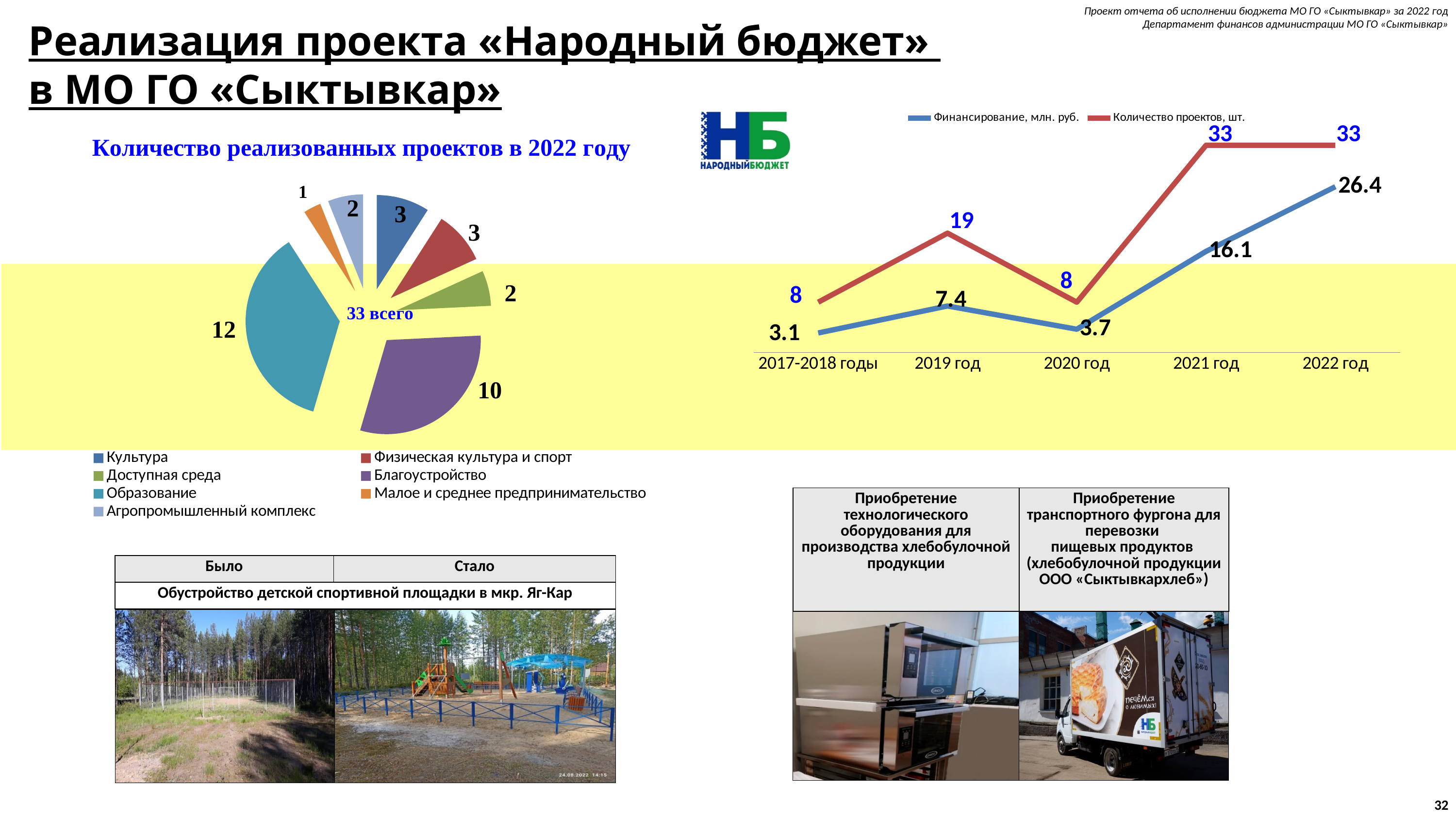
In the pie chart 'Количество реализованных проектов в 2022 году', what is the difference between 'Образование' and 'Благоустройство'? 2 In the line chart on the right, what is the difference in 'Финансирование, млн. руб.' between 2022 год and 2021 год? 10.3 In the pie chart 'Количество реализованных проектов в 2022 году', how many projects are in the 'Образование' category? 12 In the pie chart 'Количество реализованных проектов в 2022 году', what is the total number of projects shown in the centre? 33 всего In the pie chart 'Количество реализованных проектов в 2022 году', which category has the smallest number of projects? Малое и среднее предпринимательство In the pie chart 'Количество реализованных проектов в 2022 году', how many projects are in the 'Благоустройство' category? 10 In the pie chart 'Количество реализованных проектов в 2022 году', which category has the largest number of projects? Образование In the line chart on the right, how many series does the legend list? 2 What type of chart is the chart on the right showing 'Финансирование, млн. руб.' and 'Количество проектов, шт.'? line chart In the pie chart 'Количество реализованных проектов в 2022 году', how many categories are shown in the legend? 7 In the line chart on the right, what is the value of 'Финансирование, млн. руб.' for 2022 год? 26.4 In the line chart on the right, what is the value of 'Количество проектов, шт.' for 2019 год? 19